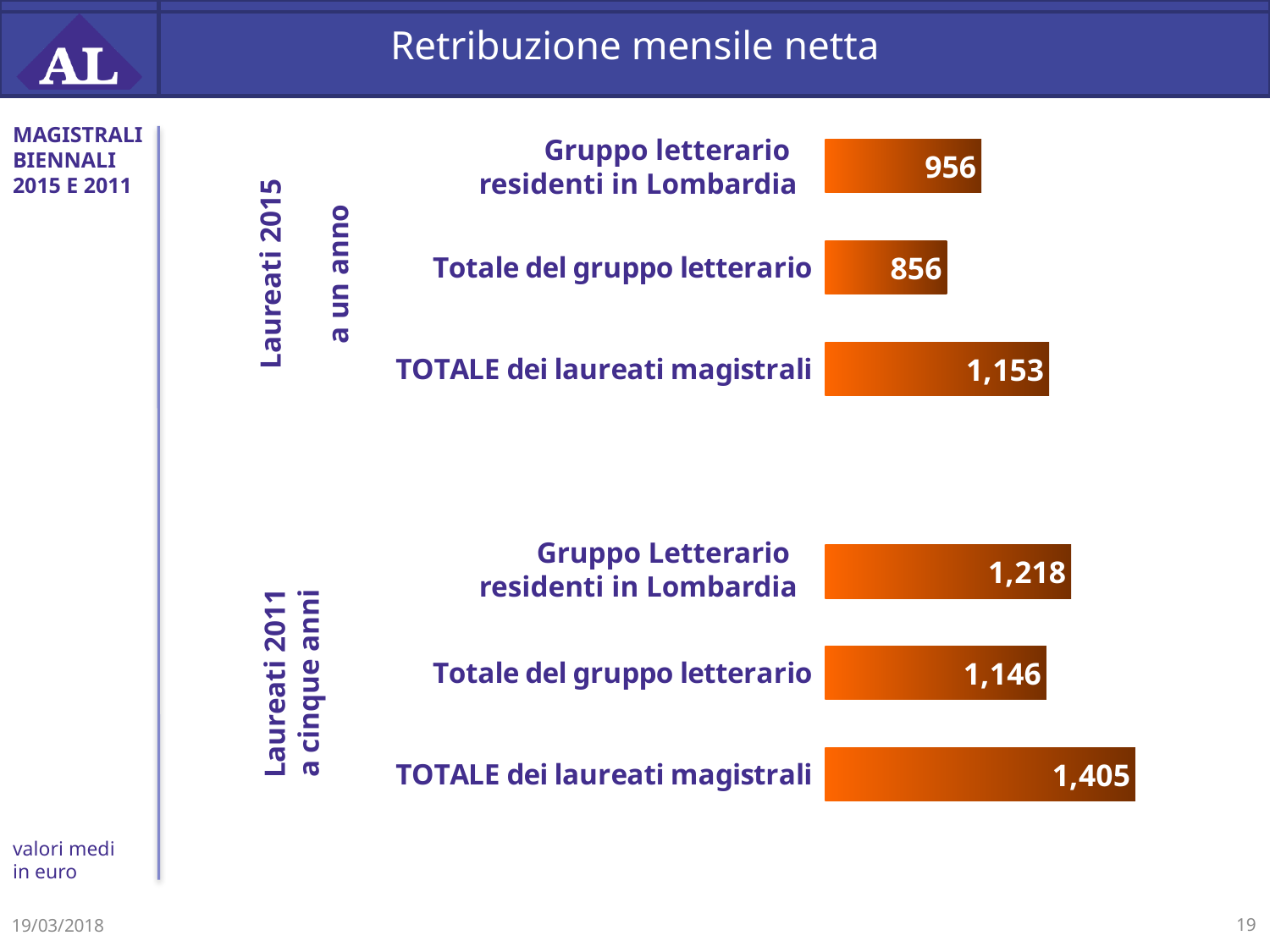
In the bottom chart (Laureati 2011 a cinque anni), what is the value for Gruppo Letterario residenti in Lombardia? 1,218 In the top chart (Laureati 2015 a un anno), what is the value for TOTALE dei laureati magistrali? 1,153 In the top chart (Laureati 2015 a un anno), what is the value for Totale del gruppo letterario? 856 In the top chart (Laureati 2015 a un anno), what is the value for Gruppo letterario residenti in Lombardia? 956 In the bottom chart (Laureati 2011 a cinque anni), what is the value for Totale del gruppo letterario? 1,146 In the top chart (Laureati 2015 a un anno), which category has the lowest value? Totale del gruppo letterario In the bottom chart (Laureati 2011 a cinque anni), what is the value for TOTALE dei laureati magistrali? 1,405 What kind of chart is used on this slide? Bar chart In the bottom chart (Laureati 2011 a cinque anni), what is the difference between Gruppo Letterario residenti in Lombardia and Totale del gruppo letterario? 72 In the bottom chart (Laureati 2011 a cinque anni), which is larger: Gruppo Letterario residenti in Lombardia or Totale del gruppo letterario? Gruppo Letterario residenti in Lombardia In the bottom chart (Laureati 2011 a cinque anni), which category has the highest value? TOTALE dei laureati magistrali In the top chart (Laureati 2015 a un anno), what is the difference between TOTALE dei laureati magistrali and Totale del gruppo letterario? 297